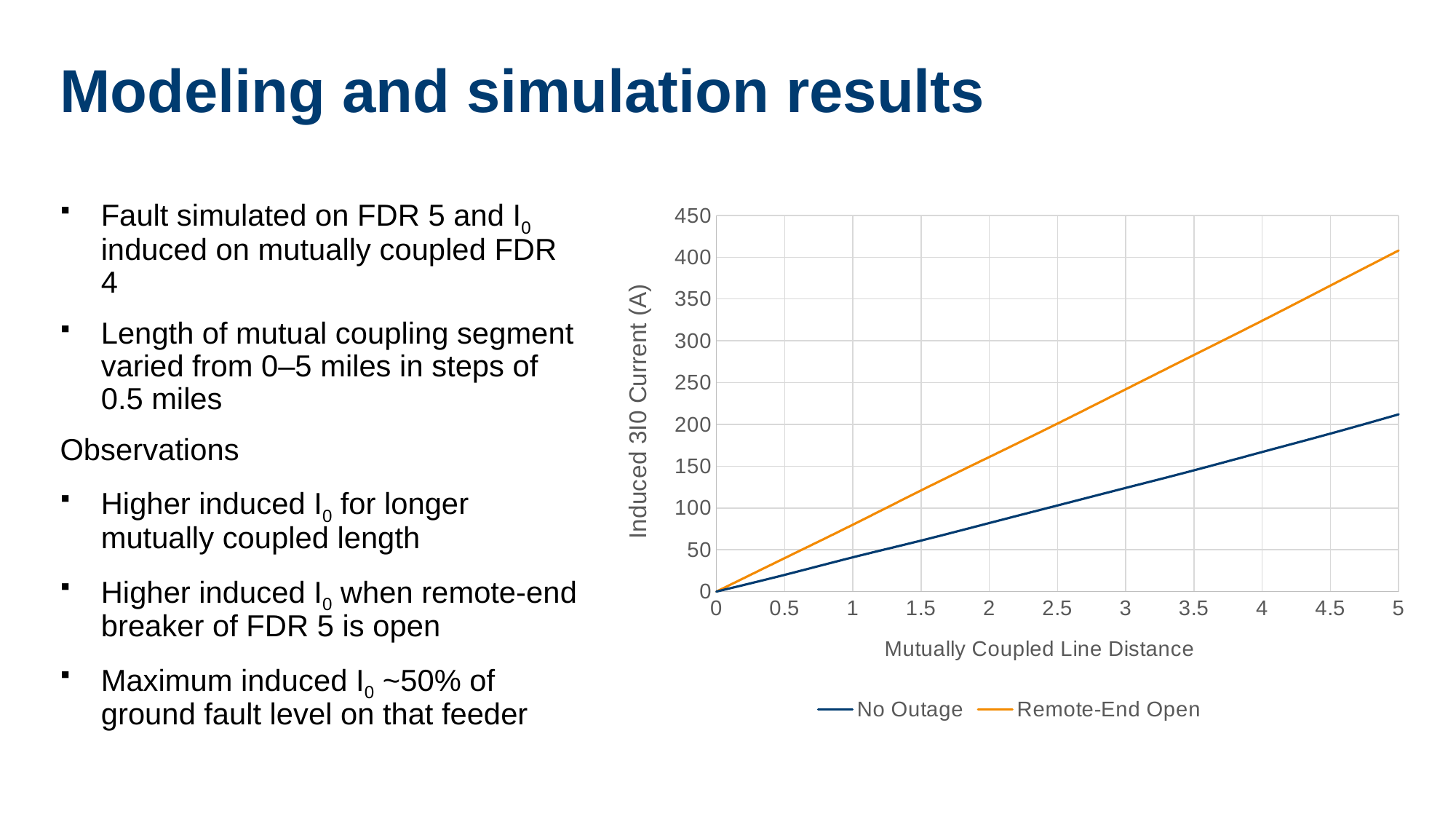
Does the Induced 3I0 Current for the No Outage series rise or fall as Mutually Coupled Line Distance increases? rise At a Mutually Coupled Line Distance of 5, which series has the higher Induced 3I0 Current, No Outage or Remote-End Open? Remote-End Open What is the Induced 3I0 Current for both series at a Mutually Coupled Line Distance of 0? 0 What kind of chart is shown on the slide? line chart Does the Remote-End Open series rise or fall along the x axis? rise Is the Remote-End Open value at a distance of 5 greater or less than 350? greater Is the Remote-End Open value at a distance of 1 greater or less than 100? less What is the title of the chart's y axis? Induced 3I0 Current (A) What are the two series named in the chart legend? No Outage and Remote-End Open Is the No Outage value at a distance of 2.5 greater or less than 150? less How many series does the chart legend list? 2